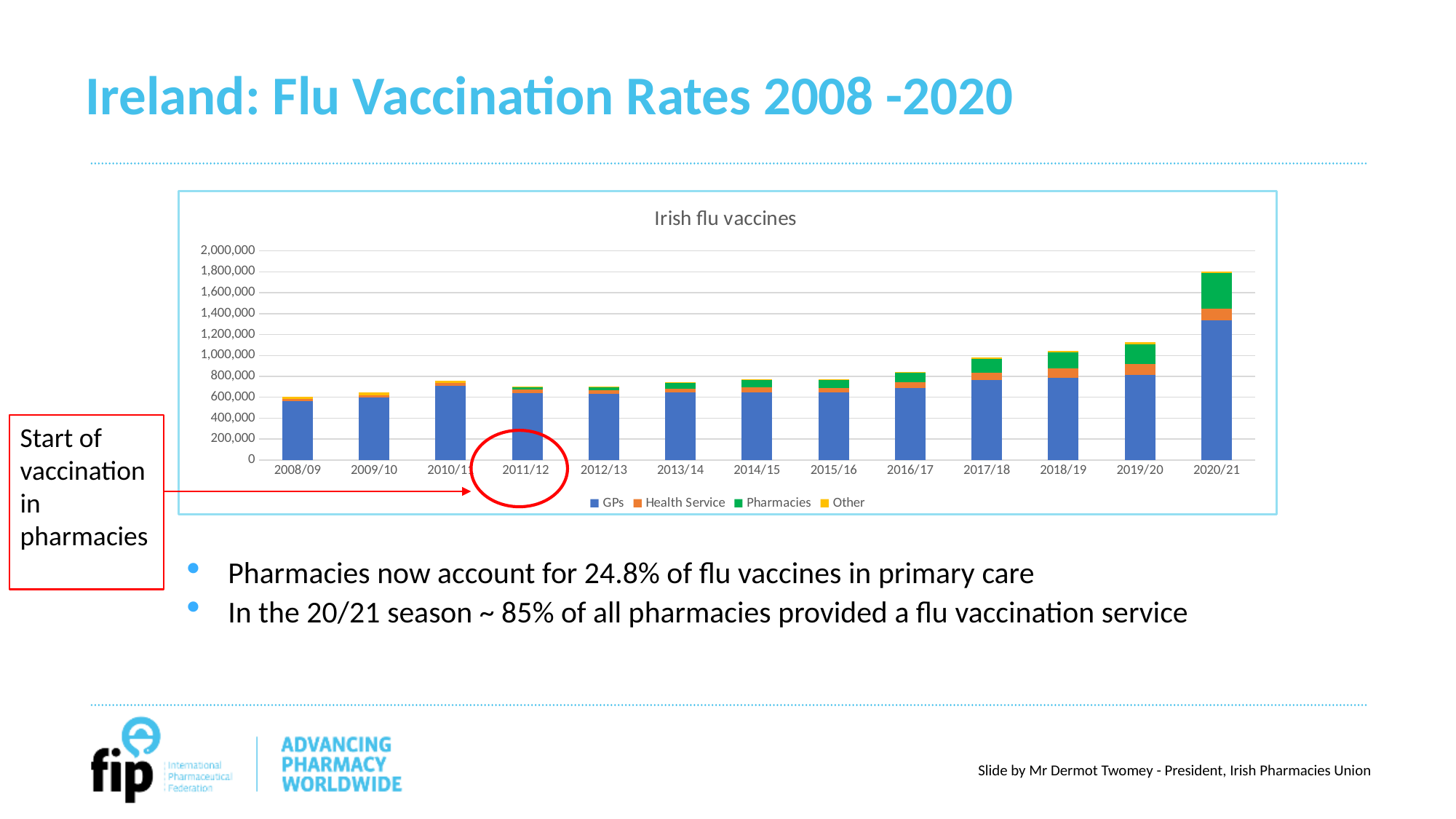
Which series is shown in green in the chart? Pharmacies How many series does the chart's legend list? 4 Do the total flu vaccine numbers generally rise or fall from 2008/09 to 2020/21? rise How many seasons (categories) are shown on the x axis of the chart? 13 Is the total for 2008/09 greater or less than 800,000? less What is the title of the chart? Irish flu vaccines Is the total for 2020/21 greater or less than 1,600,000? greater Which season has the larger total, 2018/19 or 2016/17? 2018/19 Is the total for 2019/20 greater or less than 1,000,000? greater What kind of chart is shown on the slide? Stacked bar chart Which season has the highest total number of flu vaccines in the chart? 2020/21 Which season has the lowest total number of flu vaccines in the chart? 2008/09